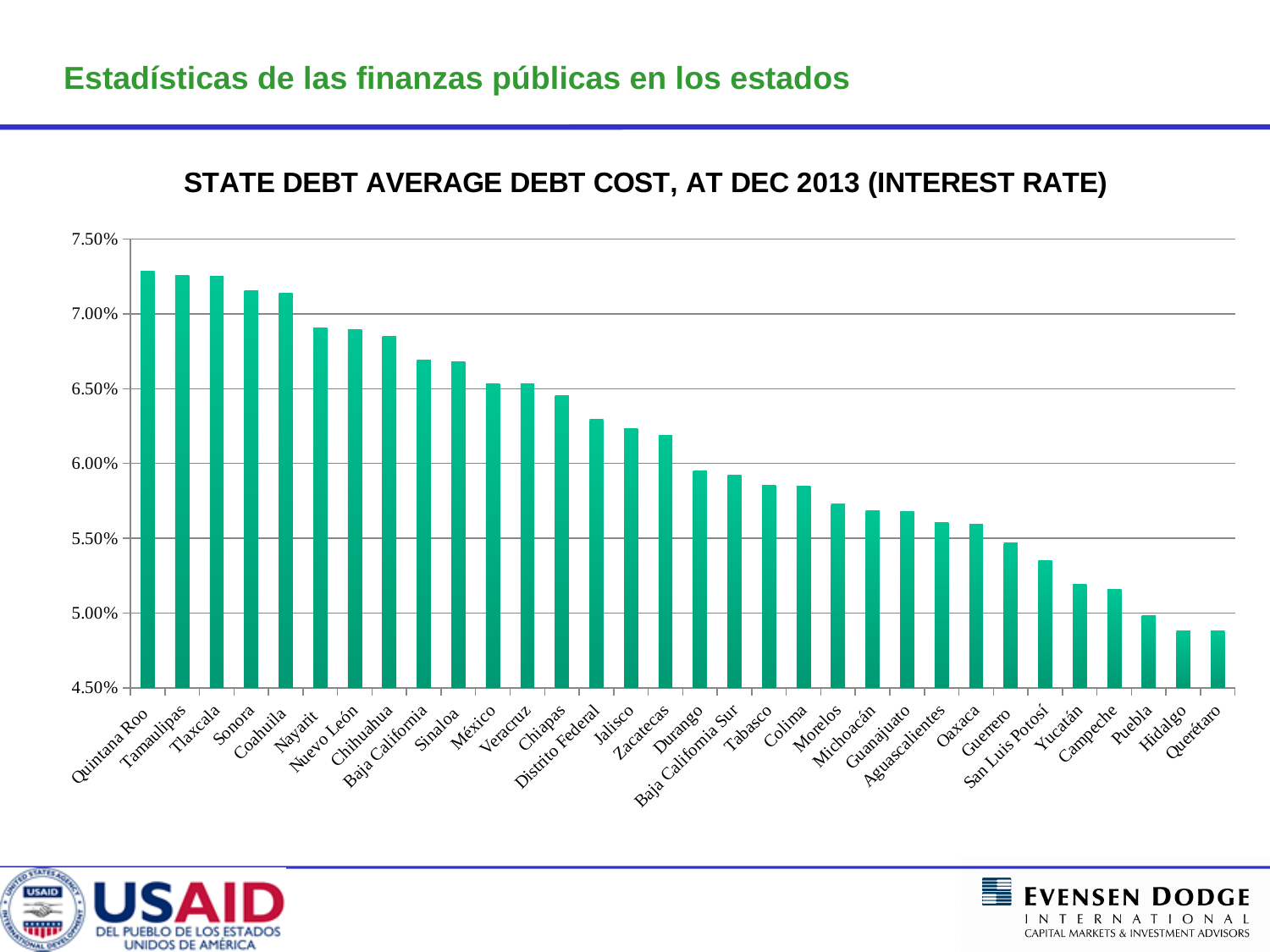
Is the value for Nayarit greater or less than 7.00%? less Which has a higher average debt cost, Sonora or Jalisco? Sonora What is the title of the chart? STATE DEBT AVERAGE DEBT COST, AT DEC 2013 (INTEREST RATE) How many states are plotted in the chart? 32 Do the values rise or fall moving from left to right along the x axis? fall Which has a lower average debt cost, Coahuila or Campeche? Campeche Is the value for Distrito Federal greater or less than 6.00%? greater Which state has the highest average debt cost in the chart? Quintana Roo Is the value for Sinaloa greater or less than 6.50%? greater What kind of chart is shown on the slide? bar chart